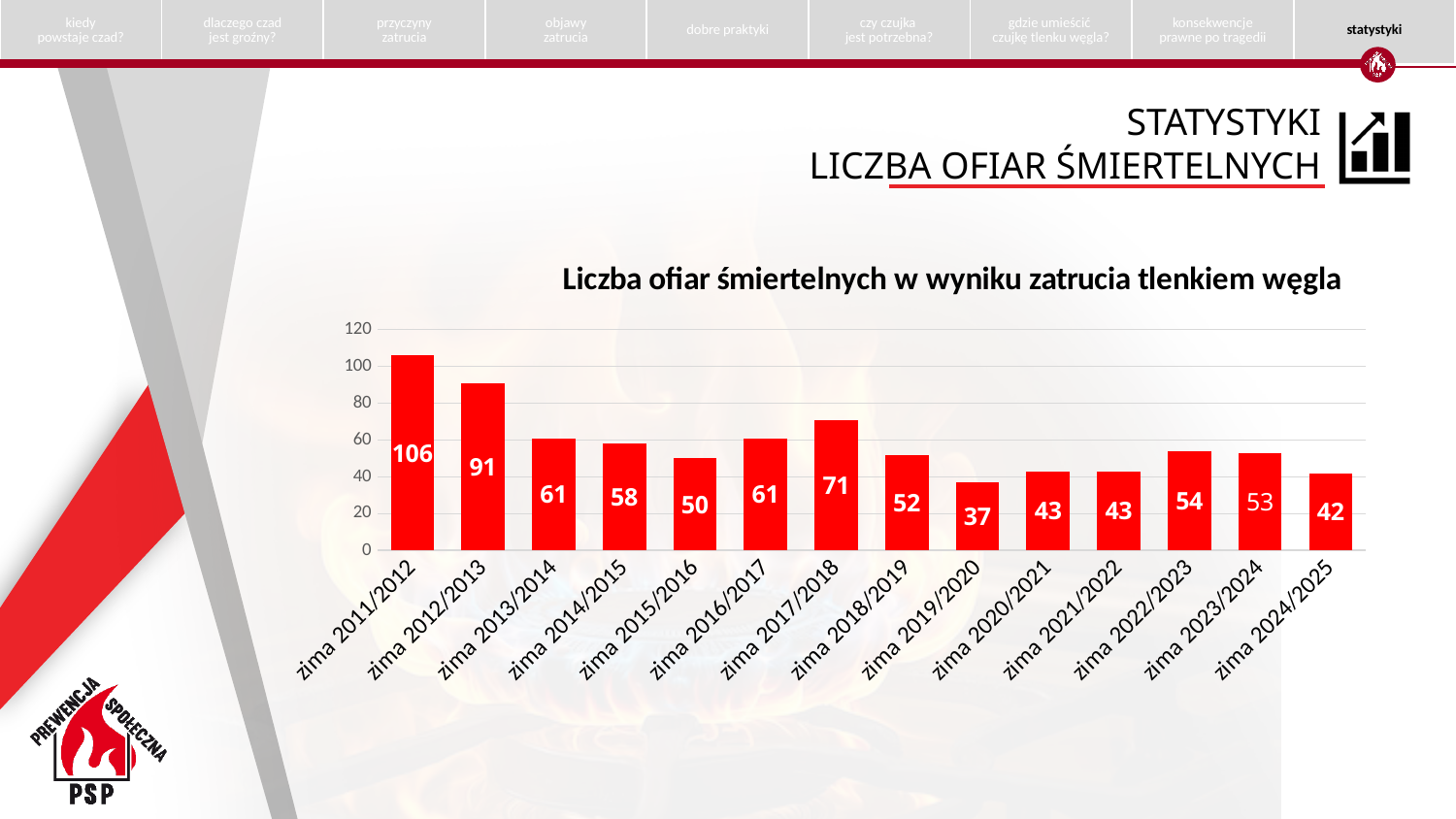
What is the value for zima 2011/2012? 106 Which category has the highest value? zima 2011/2012 What is the title of the chart? Liczba ofiar śmiertelnych w wyniku zatrucia tlenkiem węgla What is the difference between the values for zima 2011/2012 and zima 2012/2013? 15 Is the value for zima 2012/2013 greater or less than 80? greater How many categories are shown on the x axis? 14 Which category has the lowest value? zima 2019/2020 What is the difference between the values for zima 2017/2018 and zima 2024/2025? 29 What kind of chart is shown on the slide? bar chart What is the value for zima 2017/2018? 71 What is the value for zima 2023/2024? 53 Which is larger, the value for zima 2014/2015 or the value for zima 2018/2019? zima 2014/2015